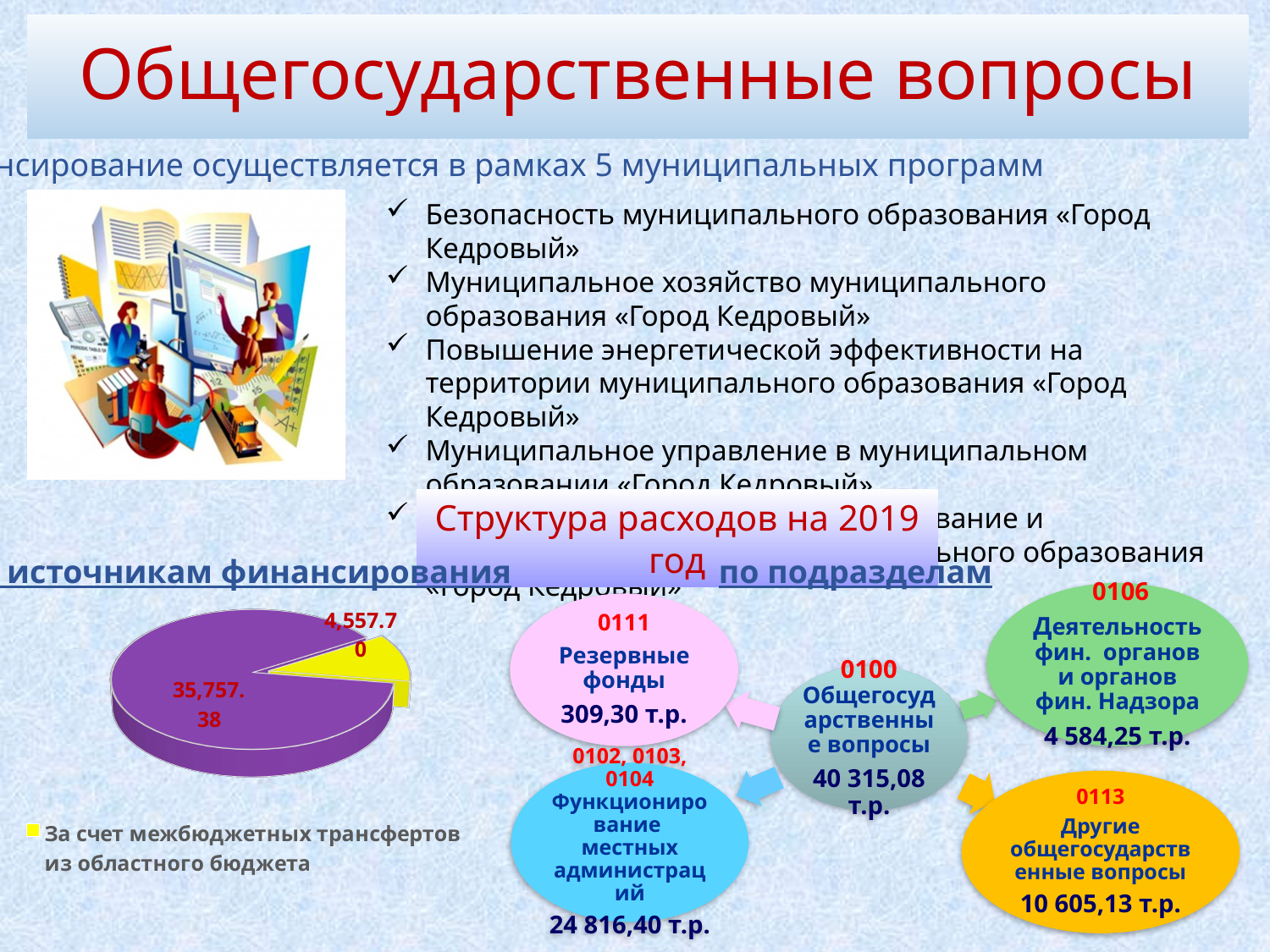
In the pie chart, what is the value of the slice labelled in the legend as «За счет межбюджетных трансфертов из областного бюджета»? 4,557.70 How many entries are listed in the legend of the pie chart? 1 What kind of chart is shown at the bottom left of the slide, under the heading «по источникам финансирования»? pie chart What colour is the slice for «За счет межбюджетных трансфертов из областного бюджета» in the pie chart? yellow In the pie chart, what is the difference between the purple slice value (35,757.38) and the yellow slice value (4,557.70)? 31,199.68 How many slices does the pie chart on the slide have? 2 What is the total of the two slice values shown in the pie chart? 40,315.08 In the pie chart, which slice is larger: the purple slice or the yellow slice? the purple slice In the pie chart, what is the value shown on the large purple slice? 35,757.38 What is the value of the largest slice in the pie chart? 35,757.38 What is the value of the smallest slice in the pie chart? 4,557.70